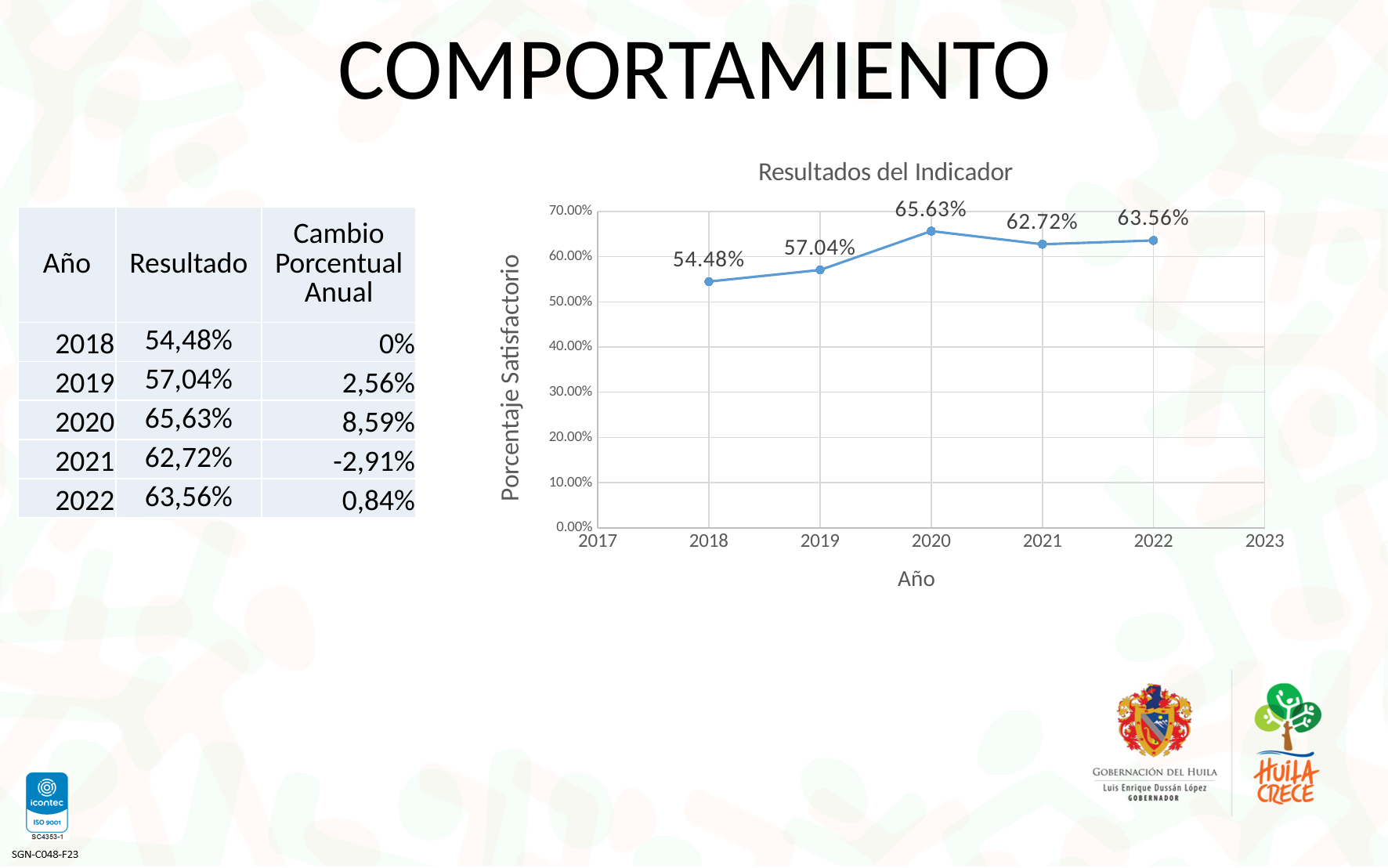
What kind of chart is shown on the slide? line chart What is the value for 2020 in the chart? 65.63% How many data points are plotted in the chart? 5 What is the difference between the values for 2020 and 2019? 8.59% Which year has the lowest value in the chart? 2018 What is the value for 2018 in the chart? 54.48% Is the value for 2019 greater or less than 60.00%? less Which is larger, the value for 2021 or the value for 2022? 2022 Does the value rise or fall from 2020 to 2021? fall What is the title of the chart? Resultados del Indicador What is the value for 2022 in the chart? 63.56% Which year has the highest value in the chart? 2020